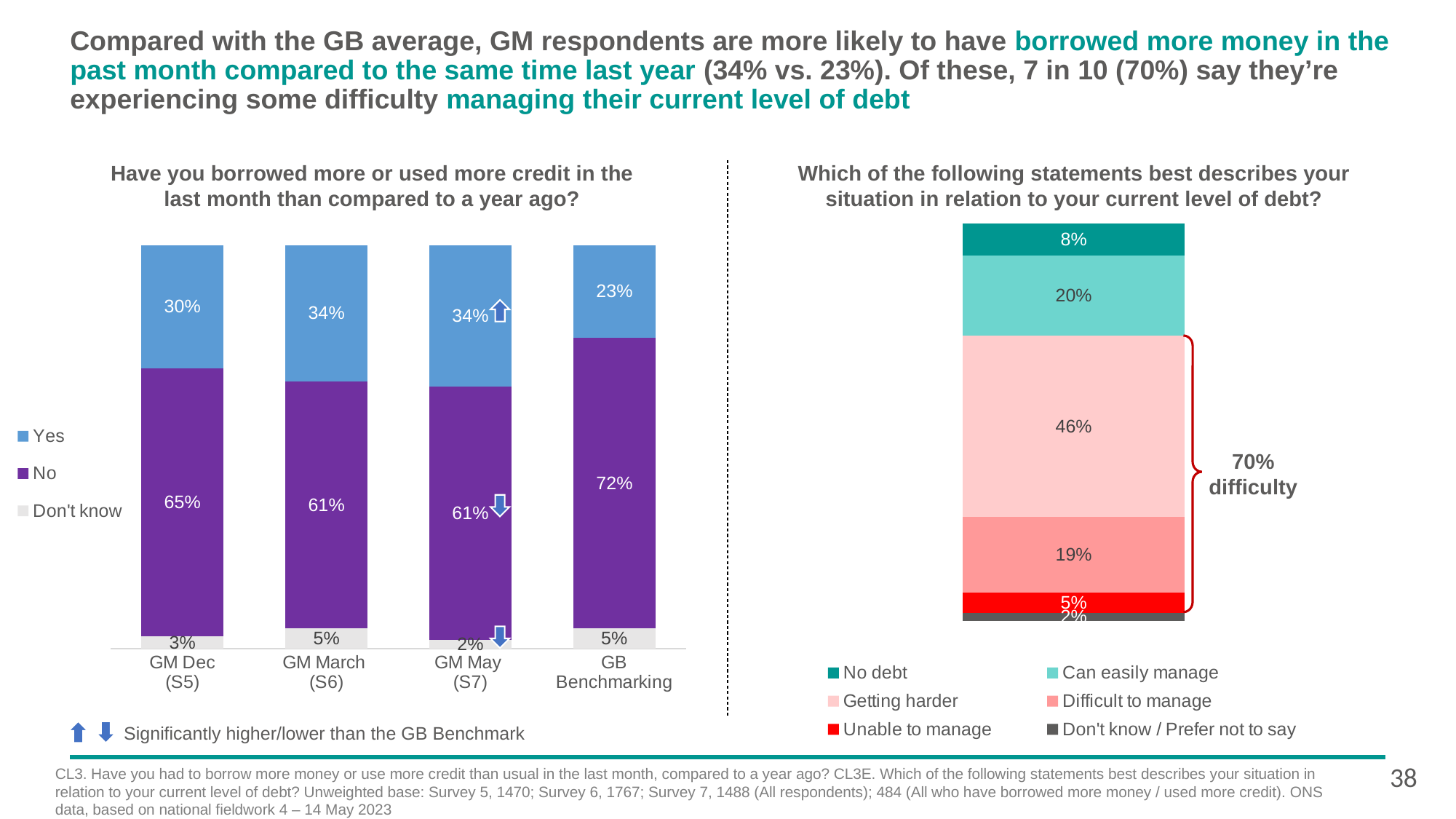
What type of chart is the left chart? Stacked bar chart In the left chart, which category has the lowest No value? GM March (S6) and GM May (S7) (both 61%) In the left chart, which category has the highest Yes value? GM March (S6) and GM May (S7) (both 34%) In the right chart ('Which of the following statements best describes your situation in relation to your current level of debt?'), what percentage said Getting harder? 46% In the left chart, what is the difference between the Yes value for GM May (S7) and the Yes value for GB Benchmarking? 11 percentage points In the left chart ('Have you borrowed more or used more credit in the last month than compared to a year ago?'), what percentage of GM May (S7) respondents answered Yes? 34% In the left chart, what is the Don't know value for GM Dec (S5)? 3% In the right chart, which statement has the lowest percentage? Don't know / Prefer not to say (2%) In the right chart, what is the combined percentage of Getting harder, Difficult to manage and Unable to manage? 70% In the left chart, how many series does the legend list? 3 In the left chart, what percentage of GB Benchmarking respondents answered No? 72% In the left chart, how many categories are shown on the x axis? 4